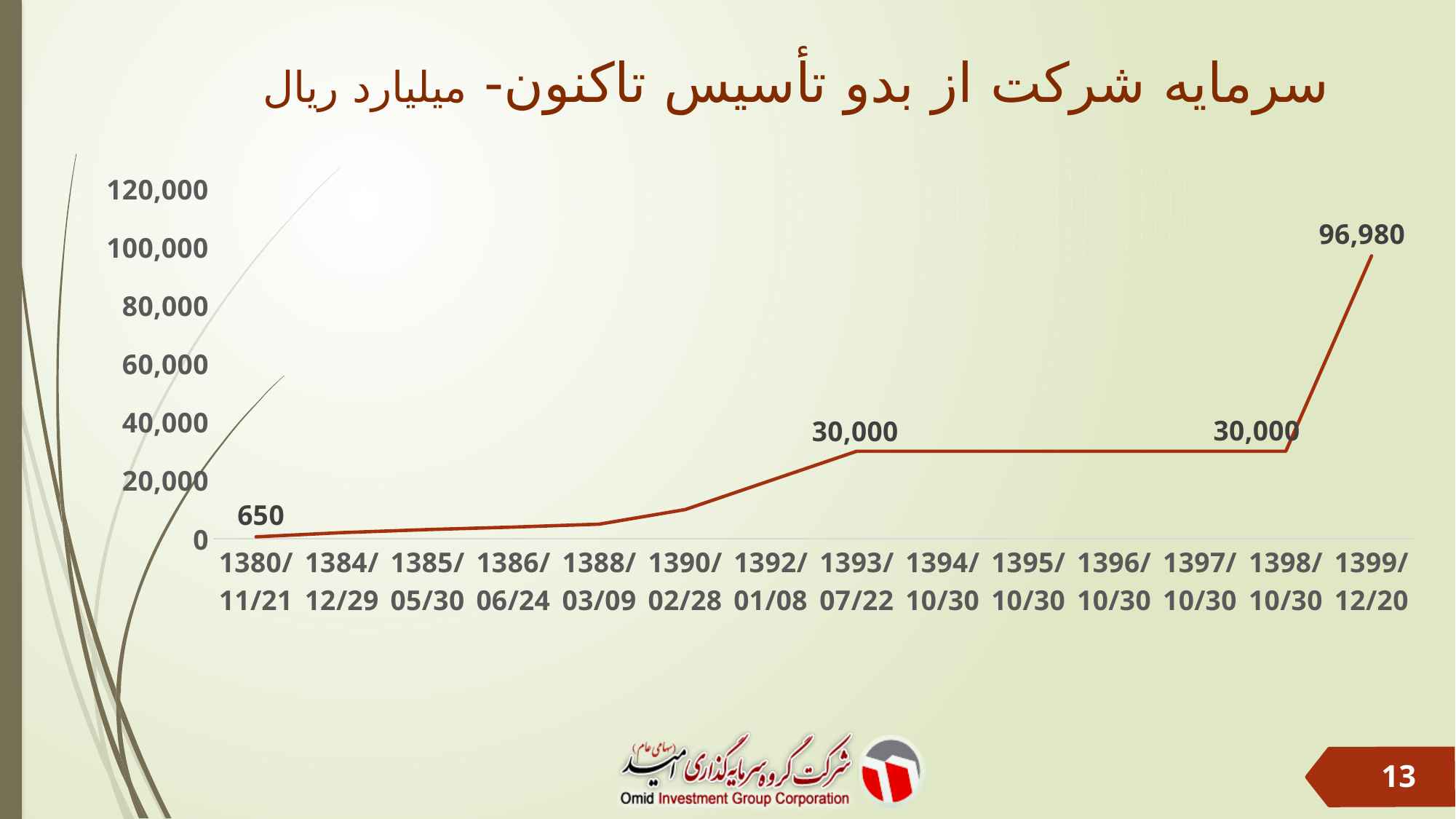
What is the difference between the values for 1399/12/20 and 1398/10/30? 66,980 Which is larger, the value for 1398/10/30 or the value for 1380/11/21? 1398/10/30 Which date has the highest value on the chart? 1399/12/20 What is the value plotted for 1393/07/22? 30,000 Is the value for 1396/10/30 greater or less than 40,000? less What is the value plotted for 1380/11/21? 650 What kind of chart is shown on the slide? line chart Which date has the lowest value on the chart? 1380/11/21 Do the values generally rise or fall from left to right along the x axis? rise What is the difference between the values for 1393/07/22 and 1380/11/21? 29,350 What is the value plotted for 1399/12/20? 96,980 How many dates are shown on the x axis? 14